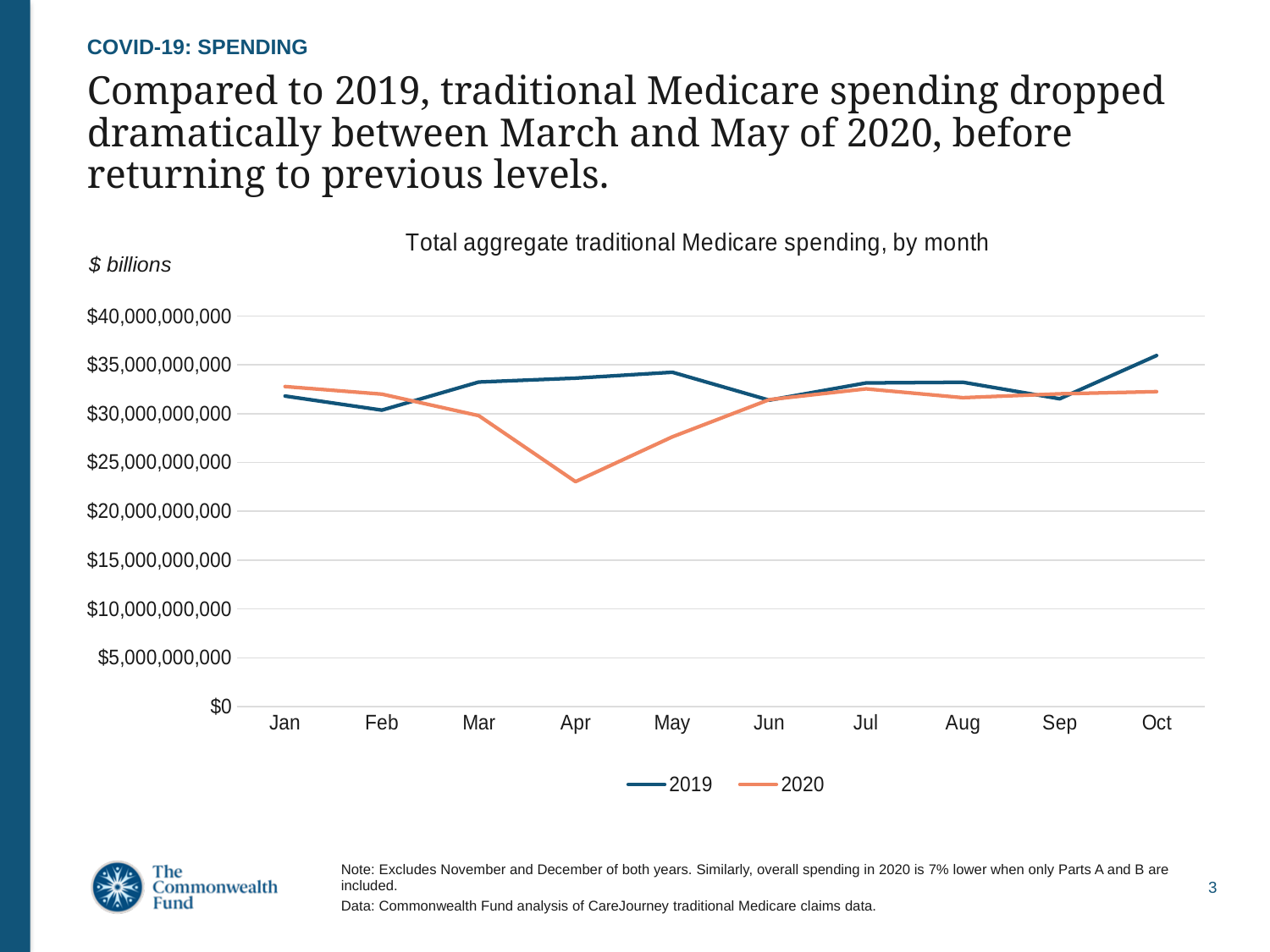
In which month is 2019 traditional Medicare spending highest? Oct In Jan, which year has the higher spending, 2019 or 2020? 2020 In which month is 2020 traditional Medicare spending lowest? Apr What is the title of the chart? Total aggregate traditional Medicare spending, by month How many months are plotted along the x axis? 10 Is the 2020 value for Apr greater or less than $25,000,000,000? less Is the 2019 value for Oct greater or less than $35,000,000,000? greater Does the 2020 line rise or fall from Mar to Apr? Fall What kind of chart is shown on the slide? Line chart In Apr, which year has the higher spending, 2019 or 2020? 2019 Is the 2020 value for May greater or less than $30,000,000,000? less How many series does the legend list? 2